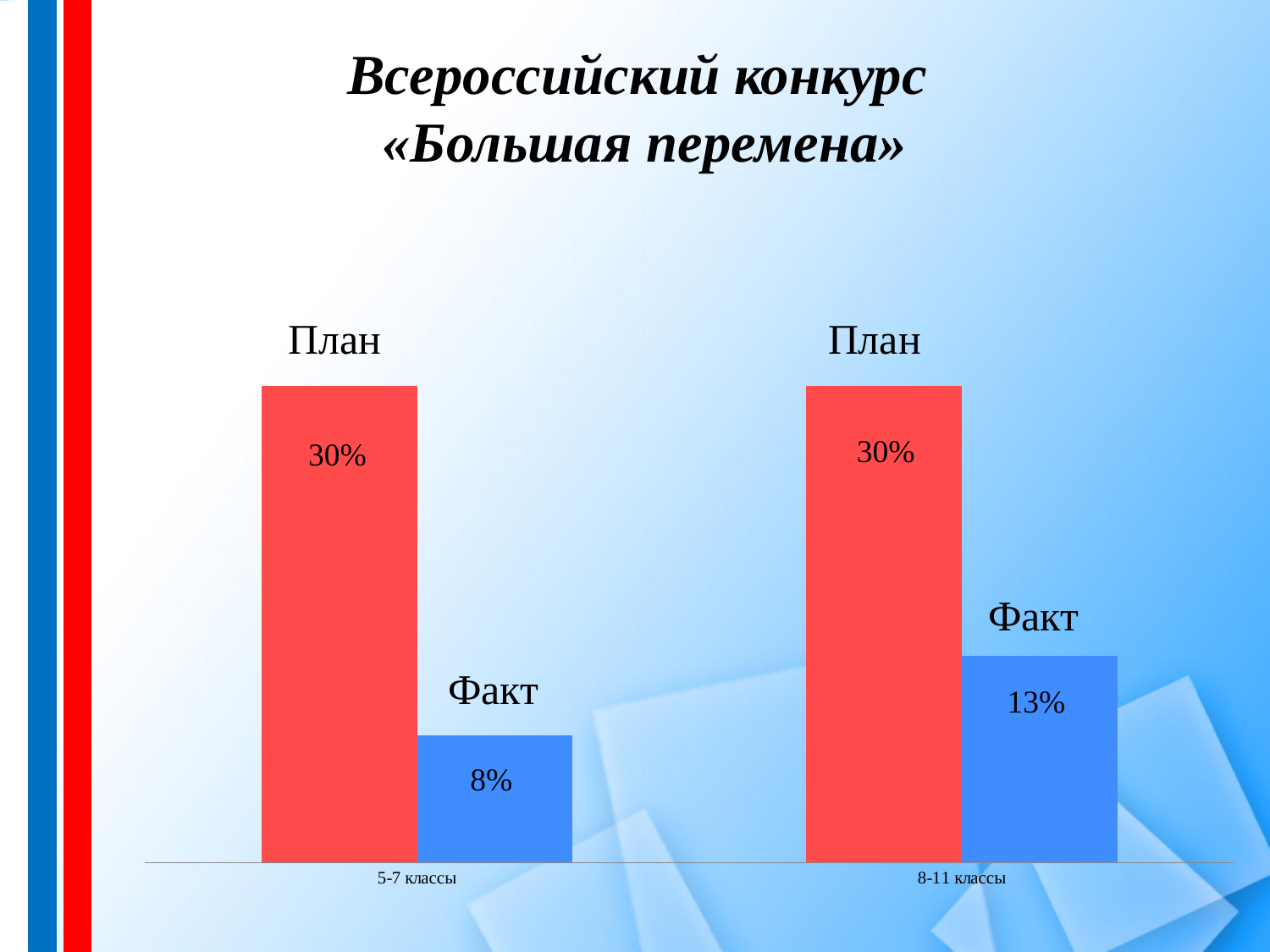
What is the difference between План and Факт for 8-11 классы? 17% Which group has the higher Факт value, 5-7 классы or 8-11 классы? 8-11 классы What is the Факт value for 8-11 классы? 13% What is the План value for 5-7 классы? 30% What is the Факт value for 5-7 классы? 8% What is the План value for 8-11 классы? 30% What is the difference between План and Факт for 5-7 классы? 22% How many categories are shown on the x axis? 2 How many series are shown for each category? 2 What colour are the План bars? Red What kind of chart is shown on the slide? Bar chart Which bar is the lowest on the chart? Факт for 5-7 классы